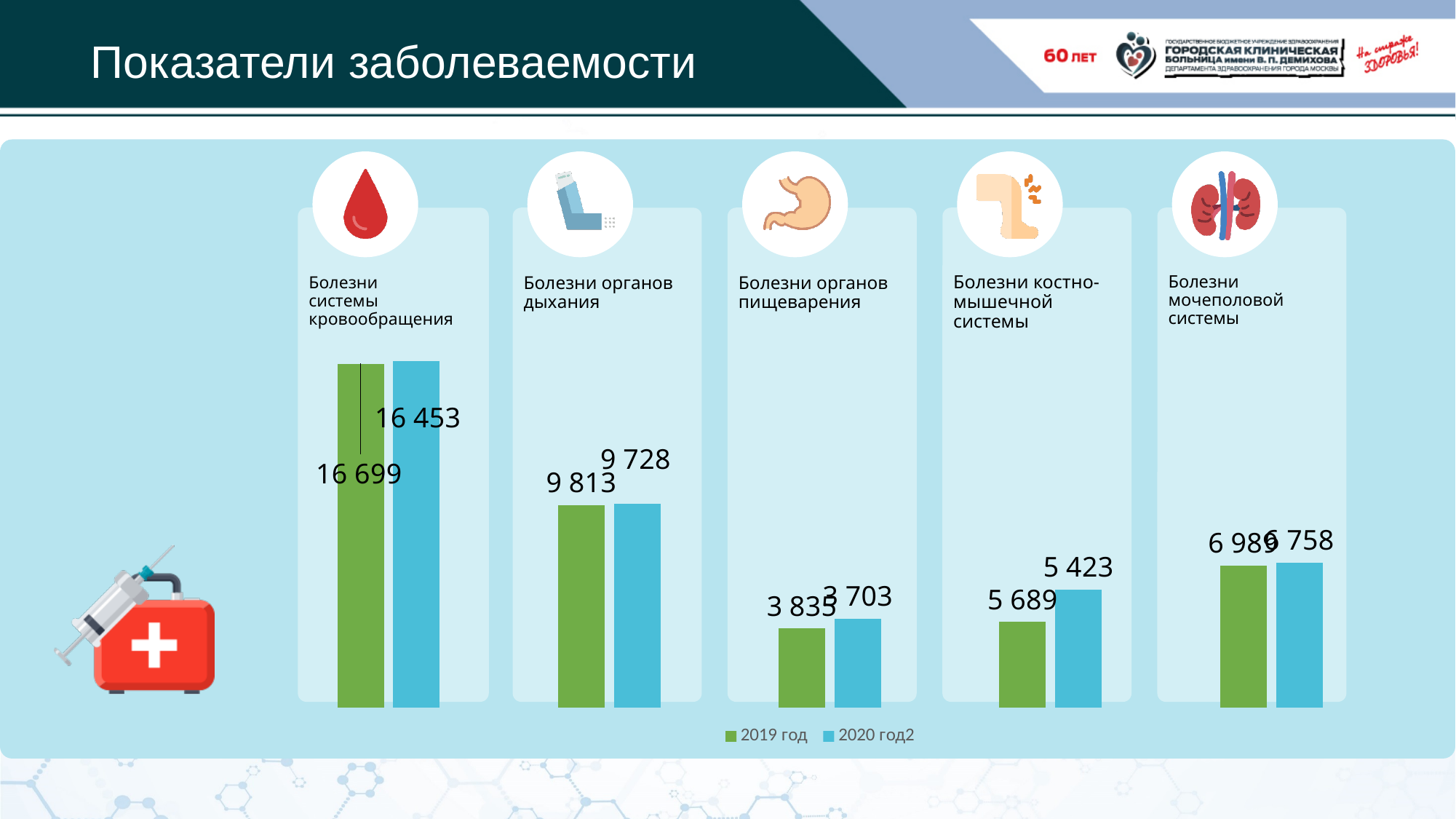
Which disease category has the lowest values in the chart? Болезни органов пищеварения What is the 2019 год value for Болезни органов дыхания? 9 813 How many series does the legend list? 2 How many disease categories are shown in the chart? 5 What is the difference between the 2019 год and 2020 год2 values for Болезни органов дыхания? 85 What is the 2019 год value for Болезни системы кровообращения? 16 699 What colour represents the 2020 год2 series in the chart? blue What type of chart is shown on the slide? bar chart What is the 2020 год2 value for Болезни системы кровообращения? 16 453 Which disease category has the highest values in the chart? Болезни системы кровообращения What is the 2020 год2 value for Болезни костно-мышечной системы? 5 423